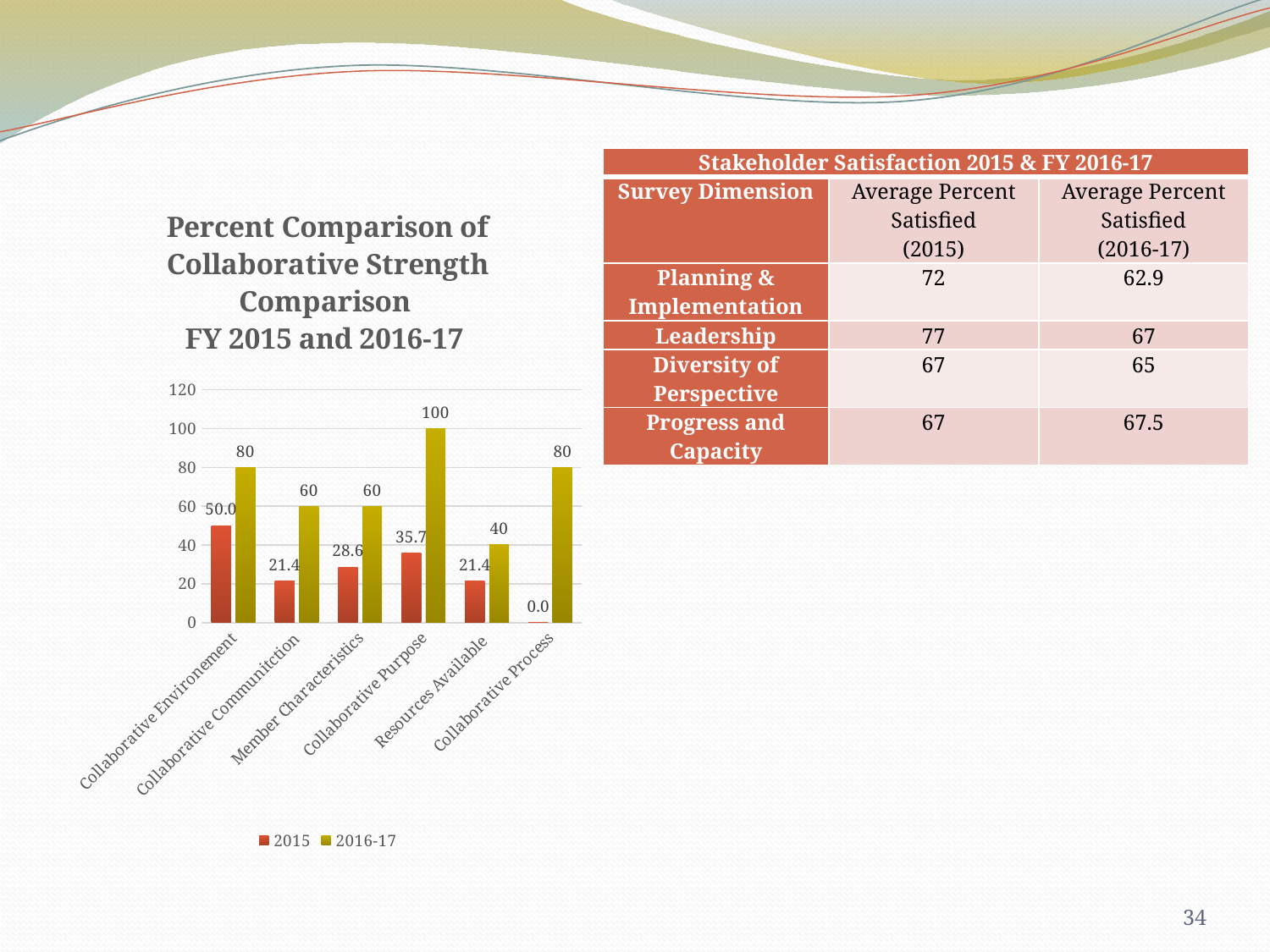
What is the 2015 value for Collaborative Purpose? 35.7 Which series is shown in yellow-green bars in the chart? 2016-17 Which category has the highest 2016-17 value? Collaborative Purpose Which is larger: the 2015 value for Member Characteristics or the 2015 value for Collaborative Communitction? Member Characteristics What is the 2016-17 value for Resources Available? 40 How many series does the chart legend list? 2 Which category has the lowest 2015 value? Collaborative Process How many categories are shown on the x axis of the chart? 6 What is the 2015 value for Collaborative Process? 0.0 What kind of chart is shown on the slide? bar chart What is the 2016-17 value for Collaborative Process? 80 What is the difference between the 2016-17 and 2015 values for Collaborative Environement? 30.0